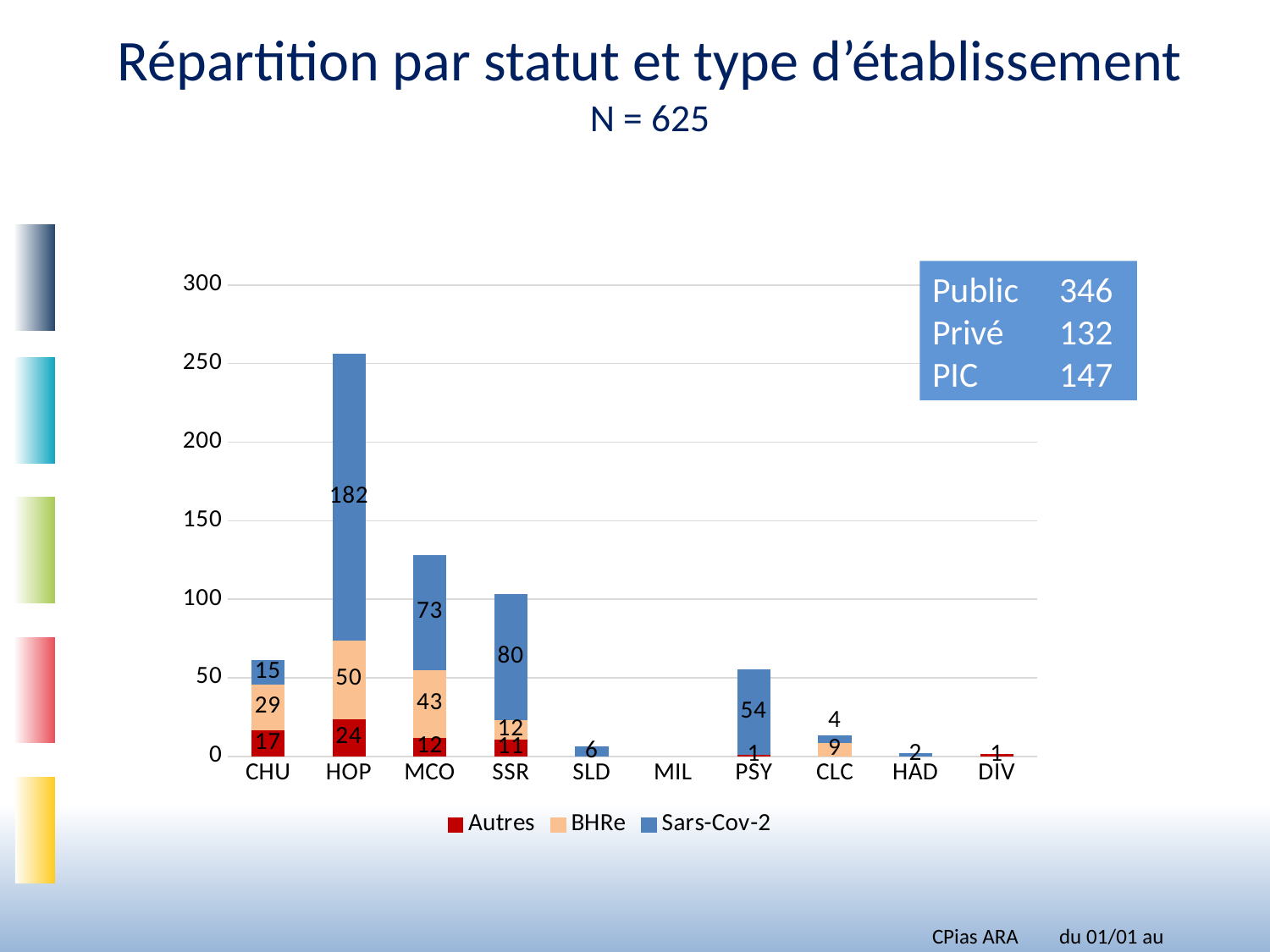
How many series does the legend list? 3 Is the total stacked bar for MCO greater or less than 100? greater What is the total of the stacked bar for HOP? 256 What is the Sars-Cov-2 value for PSY? 54 How many categories are shown on the x axis? 10 What is the BHRe value for MCO? 43 What is the difference between the Sars-Cov-2 value for SSR and the Sars-Cov-2 value for MCO? 7 Which is larger, the BHRe value for CHU or the BHRe value for HOP? HOP What is the Autres value for CHU? 17 What is the Sars-Cov-2 value for HOP? 182 Which category has the tallest stacked bar? HOP What is the total of the stacked bar for CHU? 61